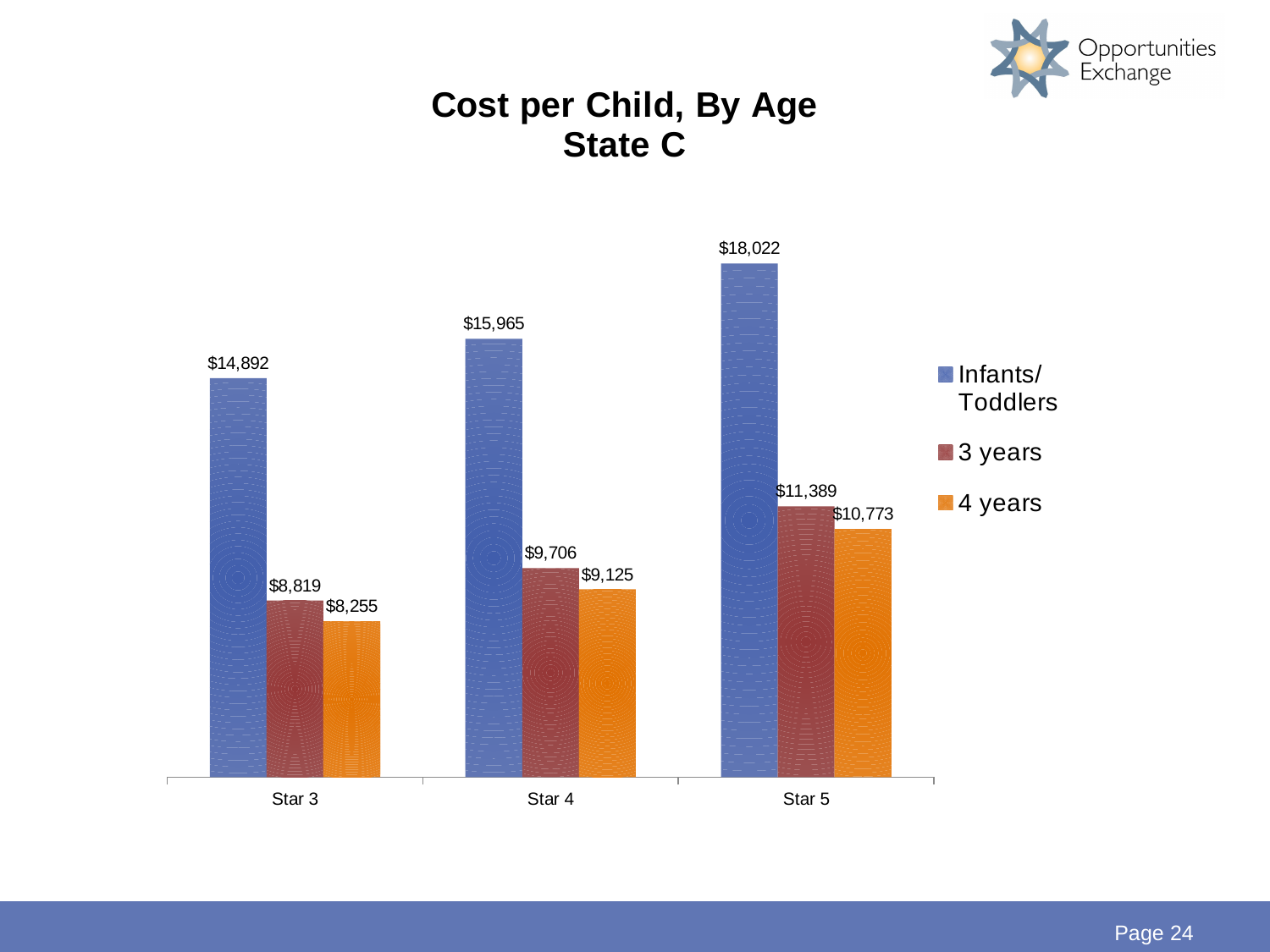
What is the difference between the 4 years cost at Star 5 and at Star 4? $1,648 Which star level has the lowest cost per child for 4 years? Star 3 What is the cost per child for 3 years at Star 4? $9,706 What is the cost per child for Infants/Toddlers at Star 5? $18,022 Which star level has the highest cost per child for Infants/Toddlers? Star 5 What is the difference between the Infants/Toddlers cost and the 3 years cost at Star 3? $6,073 How many star levels are shown on the x axis? 3 How many series does the legend list? 3 Do the Infants/Toddlers costs rise or fall from Star 3 to Star 5? Rise What is the cost per child for 4 years at Star 3? $8,255 What kind of chart is shown on the slide? Bar chart Which is larger: the 3 years cost at Star 5 or the 4 years cost at Star 5? 3 years cost at Star 5